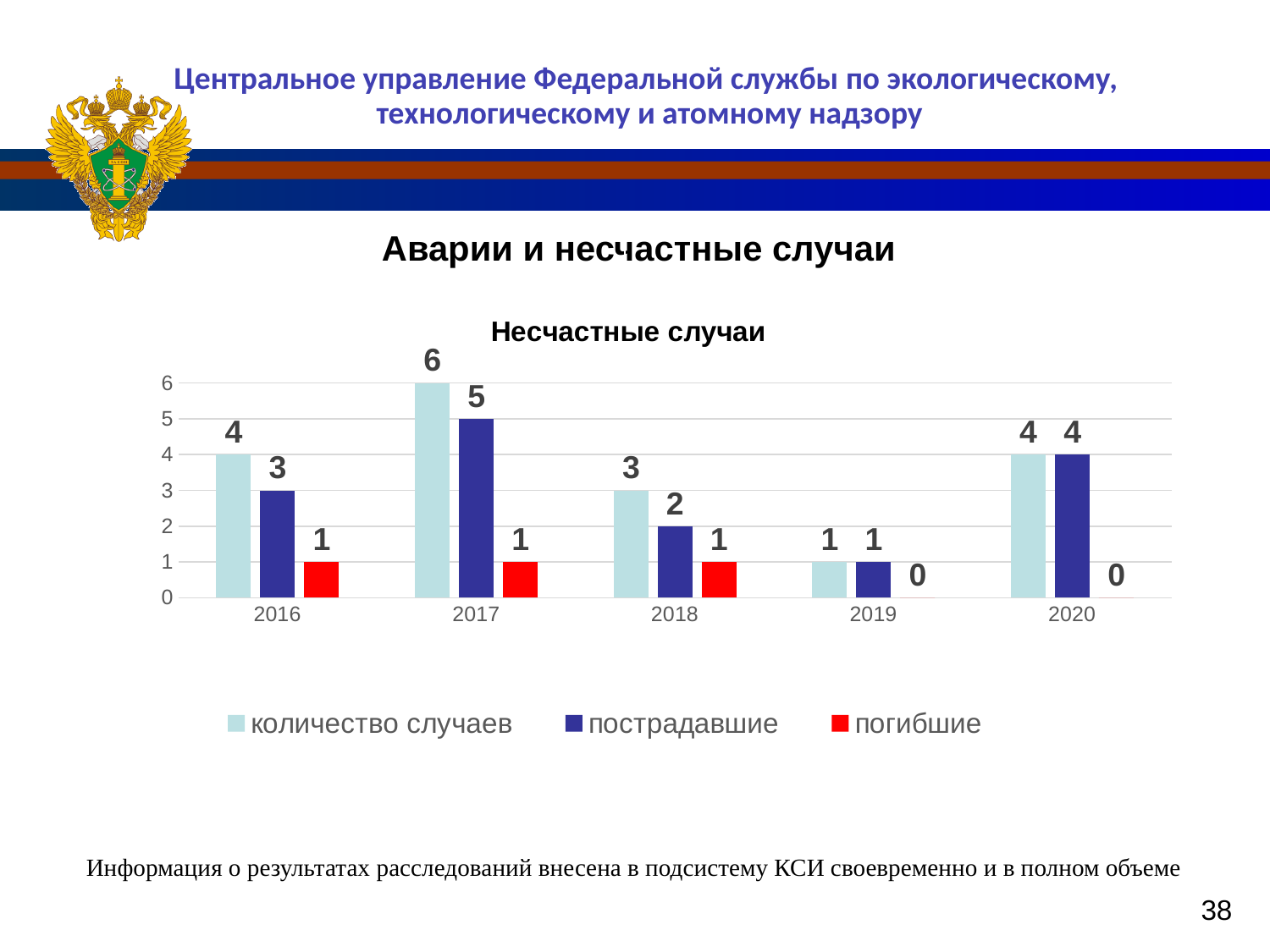
Which year has the lowest value for пострадавшие? 2019 How many years are shown on the x axis? 5 What colour represents the series погибшие? red What is the value for пострадавшие in 2018? 2 What is the value for погибшие in 2019? 0 What kind of chart is shown? bar chart What is the title of the chart? Несчастные случаи What is the value for количество случаев in 2017? 6 What is the difference between количество случаев in 2017 and in 2018? 3 Which is larger: пострадавшие in 2016 or пострадавшие in 2020? пострадавшие in 2020 How many series does the legend list? 3 Which year has the highest value for количество случаев? 2017